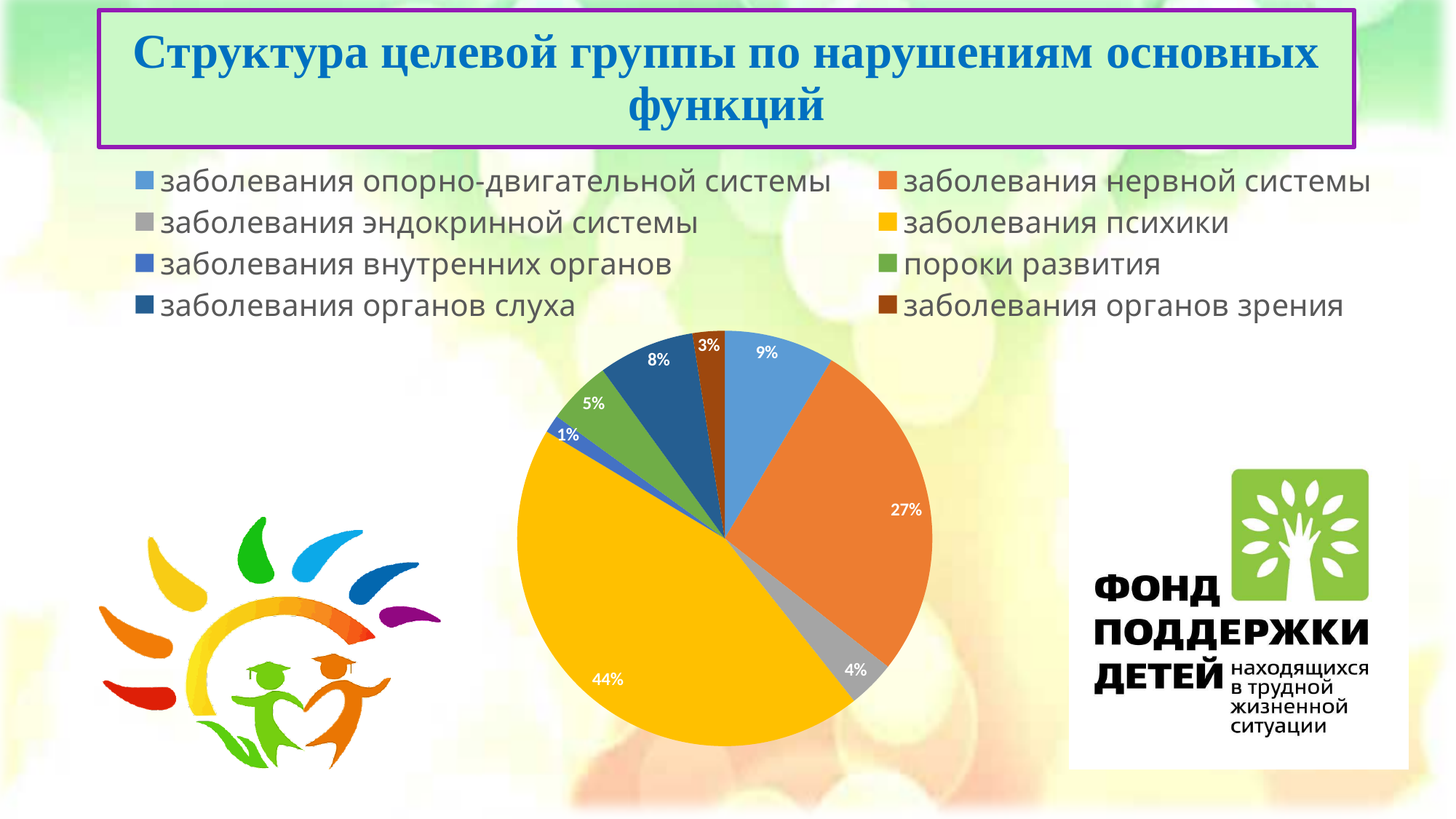
How many categories does the pie chart have? 8 What share of the pie is заболевания органов зрения? 3% Which category has the smallest share of the pie? заболевания внутренних органов Which category has the largest share of the pie? заболевания психики What colour is the slice for заболевания психики? yellow What share of the pie is заболевания нервной системы? 27% What share of the pie is заболевания опорно-двигательной системы? 9% What is the difference in percentage points between заболевания психики and заболевания нервной системы? 17 What kind of chart is shown on the slide? pie chart Which is larger: the share for пороки развития or the share for заболевания эндокринной системы? пороки развития What share of the pie is заболевания психики? 44% What share of the pie is заболевания органов слуха? 8%